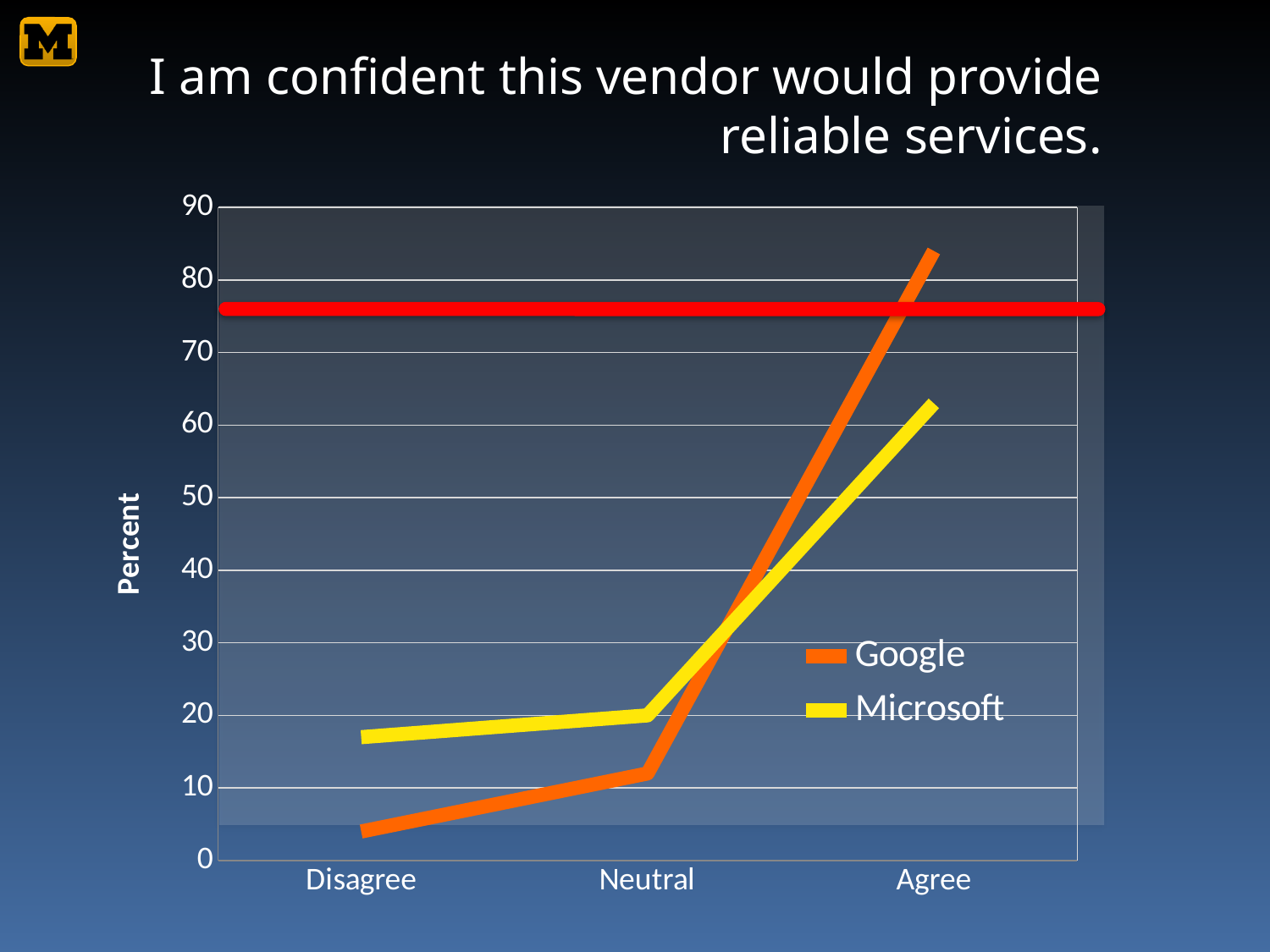
Do the values for Microsoft rise or fall from Disagree to Agree? rise For which category is the Microsoft line lowest? Disagree How many categories are shown on the x axis? 3 Is the value for Google at Agree greater or less than 80? greater Is the value for Google at Disagree greater or less than 10? less Is the value for Microsoft at Agree greater or less than 70? less At Disagree, which series has the larger value, Google or Microsoft? Microsoft What kind of chart is shown on the slide? Line chart What is the label on the vertical axis? Percent At Agree, which series has the larger value, Google or Microsoft? Google For which category is the Google line highest? Agree How many series does the legend list? 2